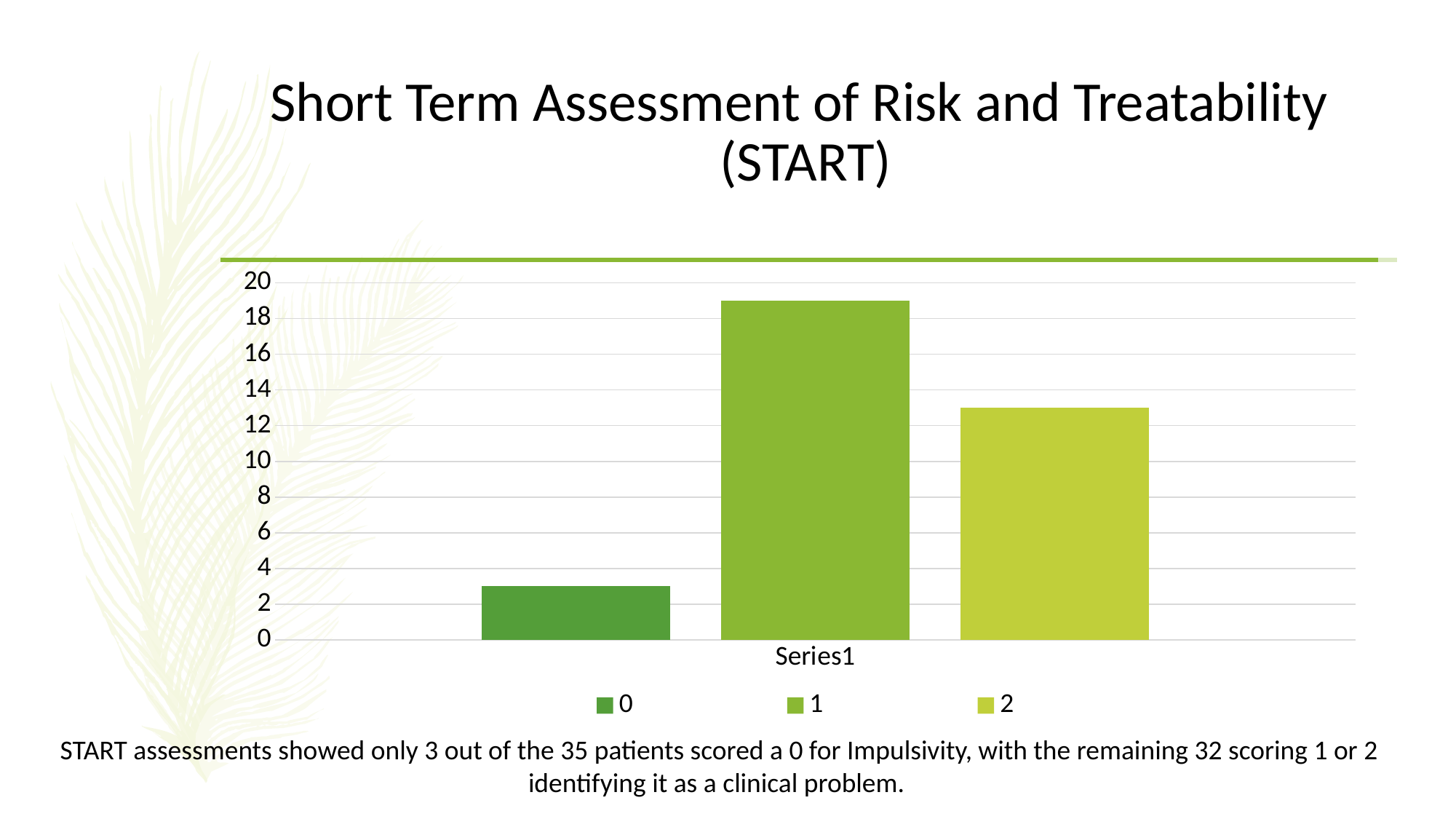
Which series has the shortest bar? 0 Is the value for series 1 greater or less than 18? greater How many series does the legend list? 3 What is the label of the single category on the x axis? Series1 Is the value for series 0 greater or less than 4? less Which is larger, the bar for series 1 or the bar for series 2? 1 What are the entries in the chart's legend? 0, 1, 2 Is the value for series 2 greater or less than 12? greater What kind of chart is shown on the slide? bar chart According to the slide, how many patients scored a 0 for Impulsivity? 3 Which series has the tallest bar? 1